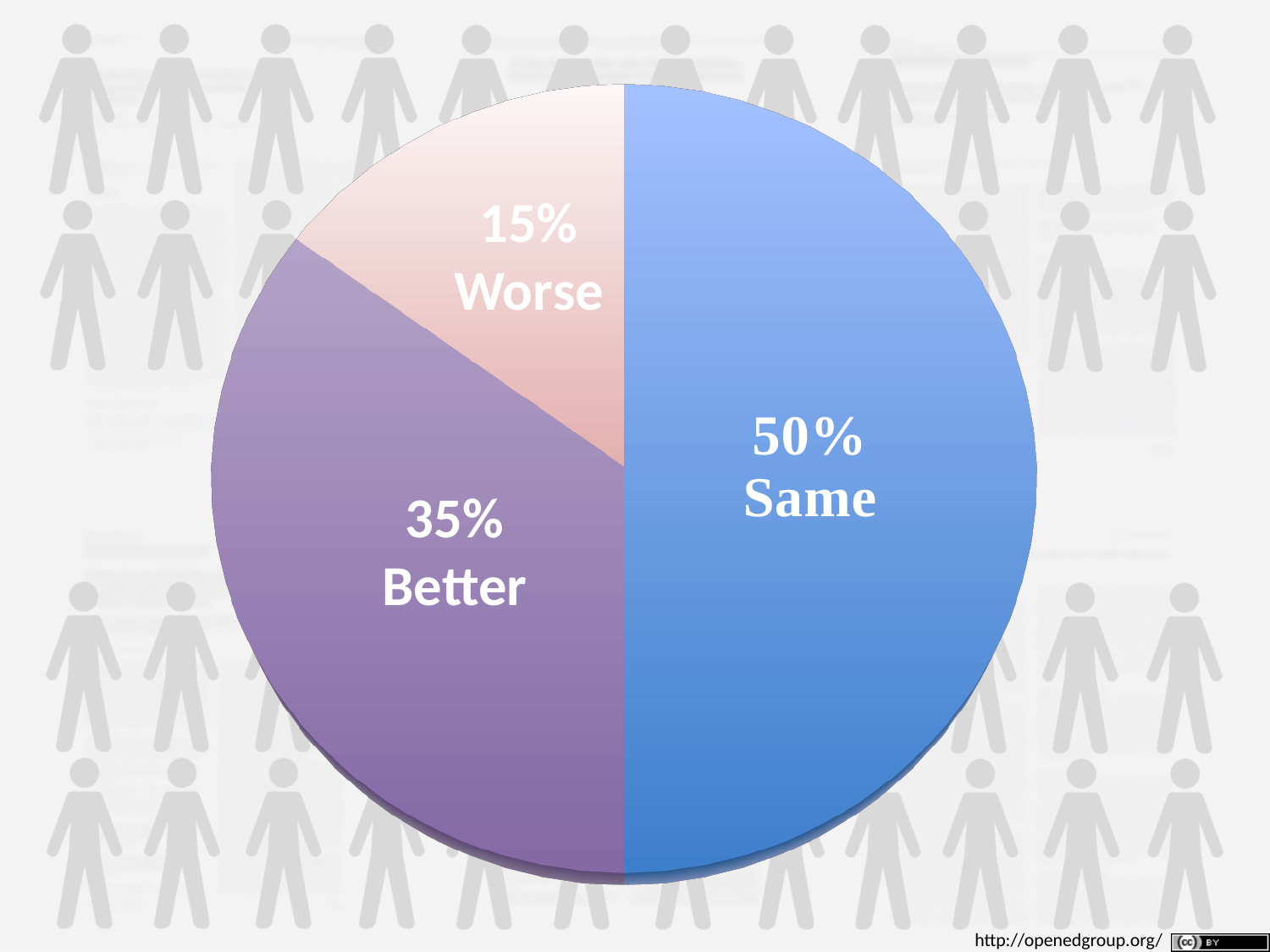
What share of the pie do the "Better" and "Worse" slices make up together? 50% What is the difference in percentage points between the "Same" slice and the "Better" slice? 15 What colour is the "Same" slice of the pie? blue What percentage of the pie is labelled "Worse"? 15% What percentage of the pie is labelled "Better"? 35% Which is larger, the "Better" slice or the "Worse" slice? Better What kind of chart is shown on the slide? pie chart What percentage of the pie is labelled "Same"? 50% Which slice of the pie is the largest? Same What is the difference in percentage points between the "Better" slice and the "Worse" slice? 20 How many slices does the pie chart have? 3 Which slice of the pie is the smallest? Worse